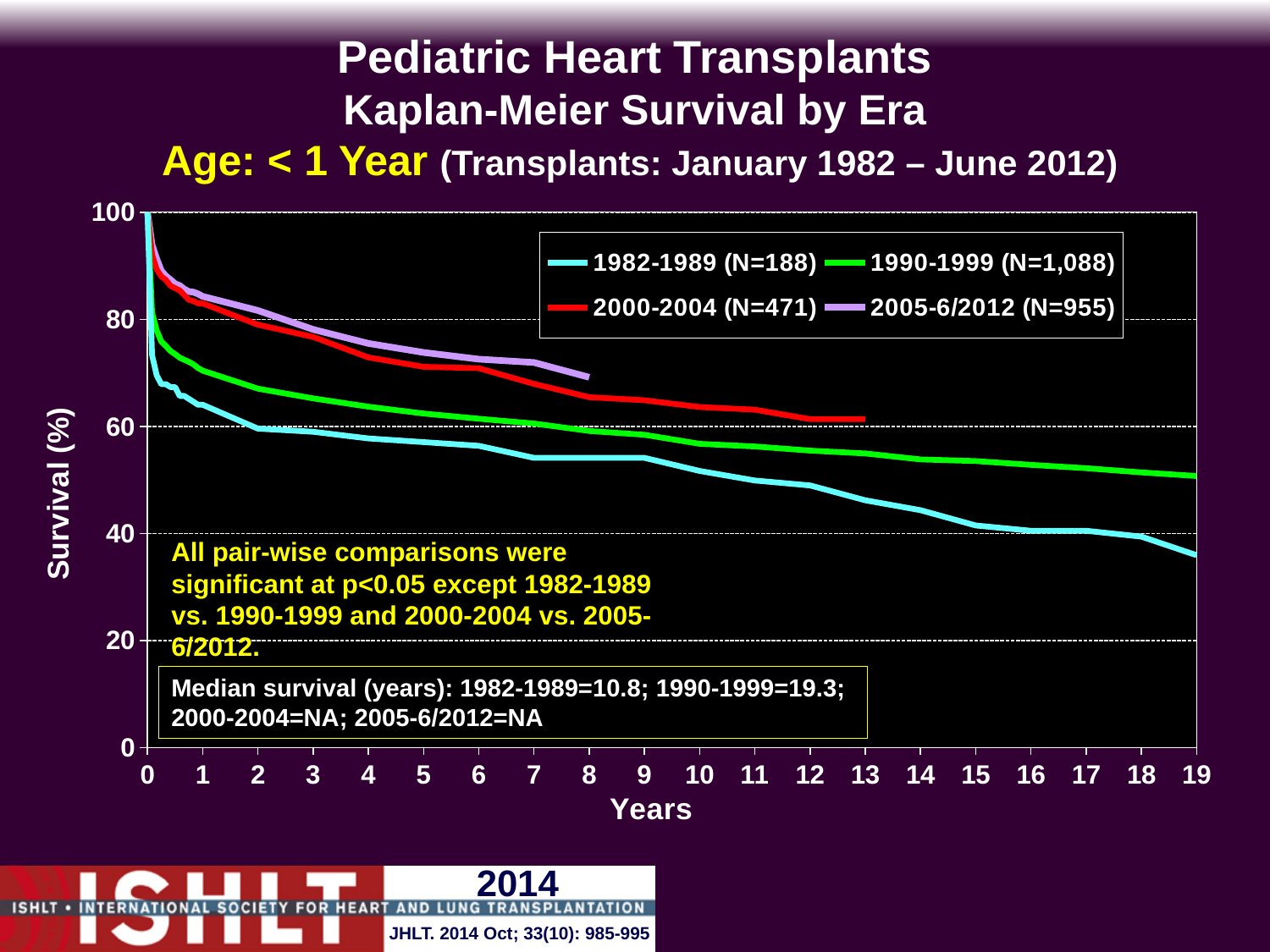
Which era has the lowest survival at 5 years? 1982-1989 Is the survival value for the 2005-6/2012 era at 8 years greater or less than 60? greater What is the N for the 1982-1989 era shown in the legend? 188 What is the median survival in years for the 1982-1989 era? 10.8 What is the median survival in years for the 1990-1999 era? 19.3 Is the survival value for the 1982-1989 era at 19 years greater or less than 40? less Do the survival curves rise or fall as years increase? Fall What is the N for the 2005-6/2012 era shown in the legend? 955 What kind of chart is shown on the slide? Line chart What is the label on the y axis? Survival (%) How many series (eras) does the legend list? 4 Which era has the highest survival at 5 years? 2005-6/2012